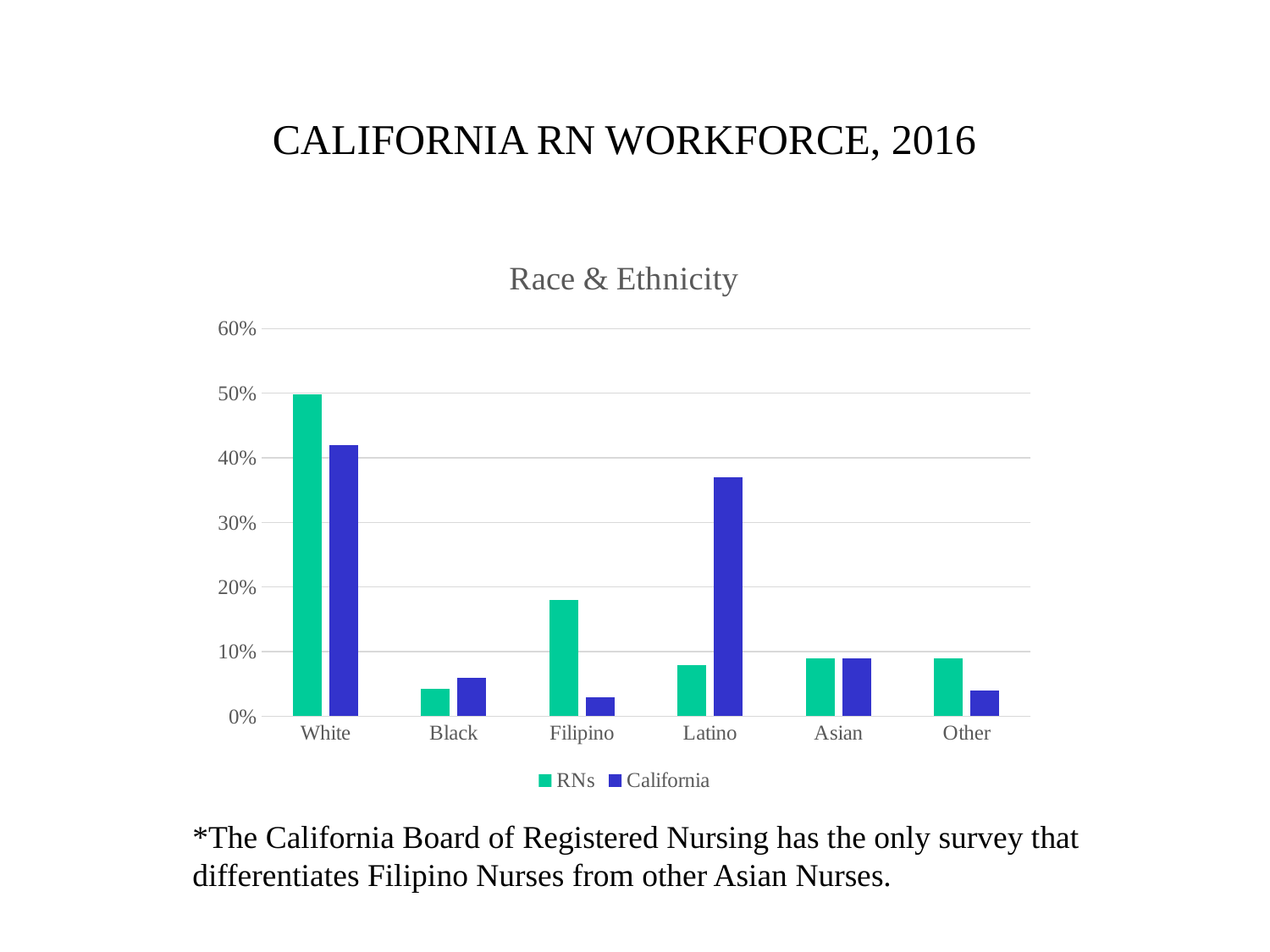
Is the RNs value for Filipino greater or less than 10%? greater Which category has the lowest value for the RNs series? Black Is the RNs value for White greater or less than 40%? greater What is the title of the chart? Race & Ethnicity How many race/ethnicity categories are shown on the x axis? 6 For Latino, which series has the larger value, RNs or California? California What kind of chart is shown on the slide? bar chart Which category has the highest value for the RNs series? White Is the California value for Filipino greater or less than 10%? less How many series does the legend list? 2 Which category has the highest value for the California series? White